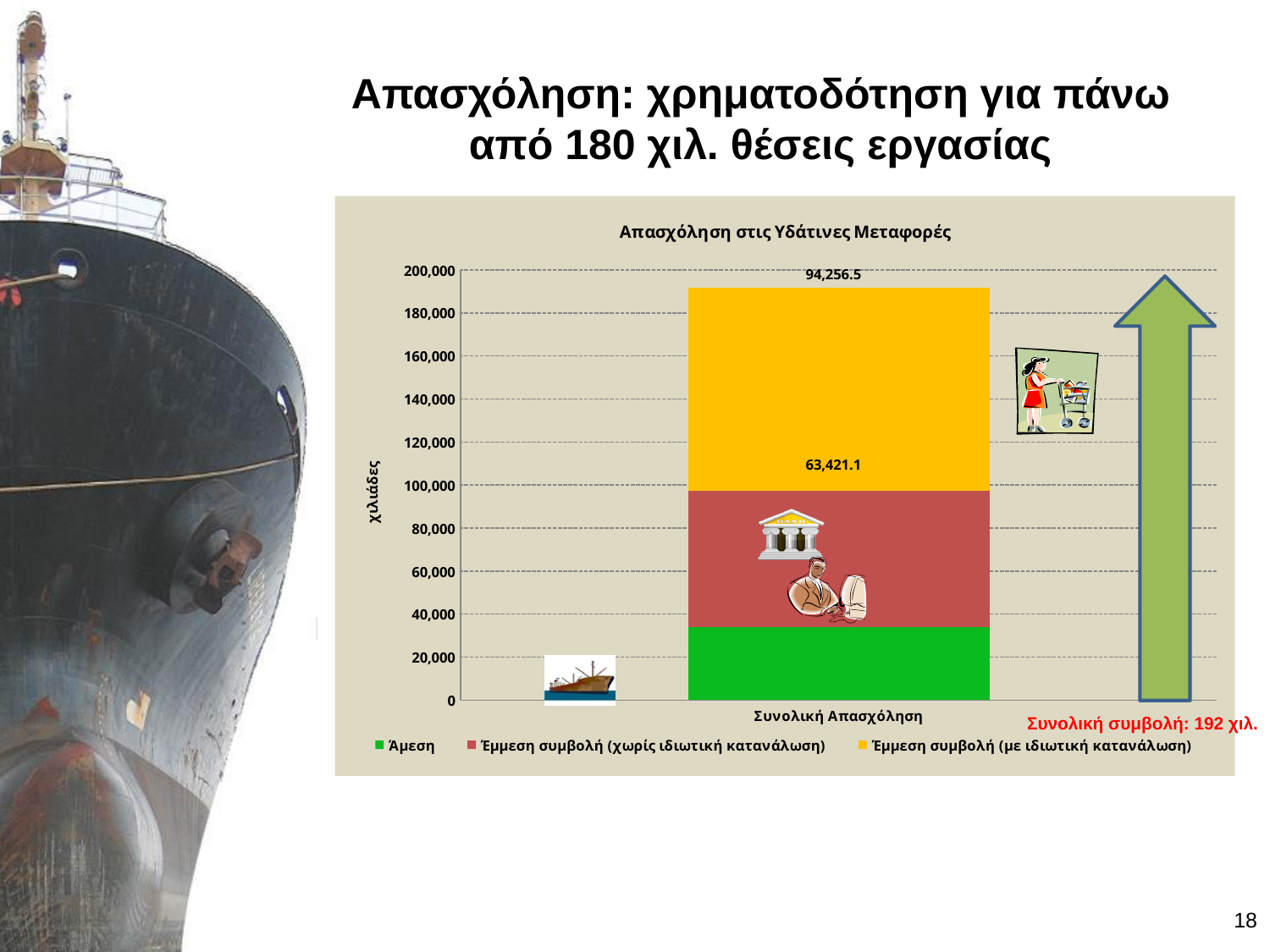
What is the title of the chart? Απασχόληση στις Υδάτινες Μεταφορές Which is larger, the 'Έμμεση συμβολή (με ιδιωτική κατανάλωση)' segment or the 'Έμμεση συμβολή (χωρίς ιδιωτική κατανάλωση)' segment? Έμμεση συμβολή (με ιδιωτική κατανάλωση) What is the value of the 'Έμμεση συμβολή (με ιδιωτική κατανάλωση)' segment? 94,256.5 What colour represents the 'Άμεση' series? green What is the value of the 'Έμμεση συμβολή (χωρίς ιδιωτική κατανάλωση)' segment? 63,421.1 How many series does the legend list? 3 What kind of chart is shown on the slide? stacked bar chart What is the difference between the 'Έμμεση συμβολή (με ιδιωτική κατανάλωση)' and 'Έμμεση συμβολή (χωρίς ιδιωτική κατανάλωση)' values? 30,835.4 How many categories are plotted on the x axis? 1 Which series has the smallest segment in the stacked bar? Άμεση Is the value of the 'Άμεση' segment greater or less than 40,000? less Which series has the largest segment in the stacked bar? Έμμεση συμβολή (με ιδιωτική κατανάλωση)